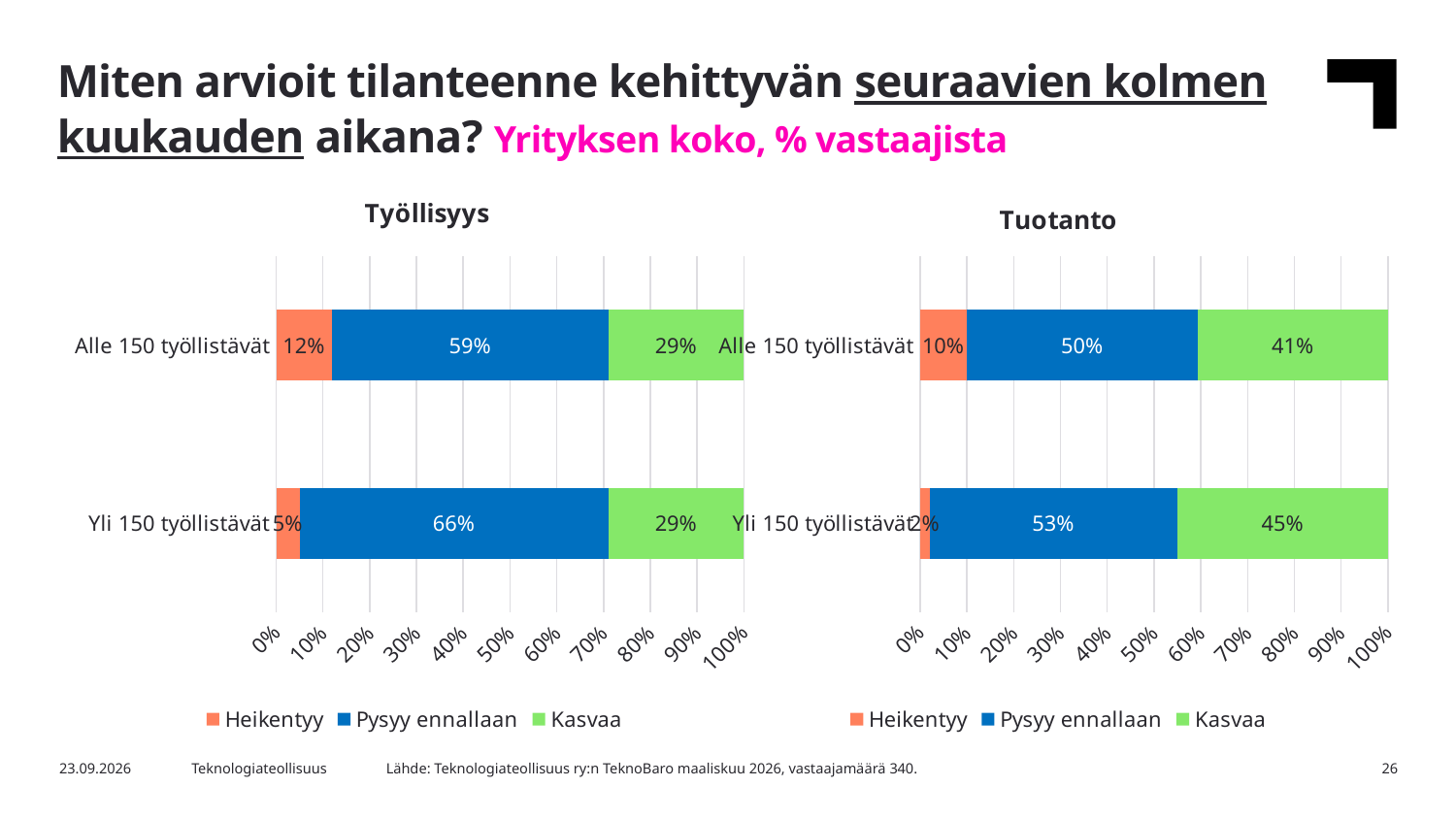
How many series does the legend of the Tuotanto chart list? 3 In the Työllisyys chart, what is the Heikentyy value for Yli 150 työllistävät? 5% In the Tuotanto chart, what is the difference between the Kasvaa values for Yli 150 työllistävät and Alle 150 työllistävät? 4 percentage points In the Työllisyys chart, what is the difference between the Pysyy ennallaan values for Yli 150 työllistävät and Alle 150 työllistävät? 7 percentage points What type of chart is the Työllisyys chart? Stacked bar chart In the Tuotanto chart, which category has the higher Kasvaa value? Yli 150 työllistävät How many categories are shown in the Työllisyys chart? 2 In the Työllisyys chart, which category has the higher Heikentyy value, Alle 150 työllistävät or Yli 150 työllistävät? Alle 150 työllistävät In the Tuotanto chart, what is the Pysyy ennallaan value for Yli 150 työllistävät? 53% In the Tuotanto chart, what is the Heikentyy value for Alle 150 työllistävät? 10% In the Tuotanto chart, what is the Kasvaa value for Yli 150 työllistävät? 45% In the Työllisyys chart, what is the Pysyy ennallaan value for Alle 150 työllistävät? 59%